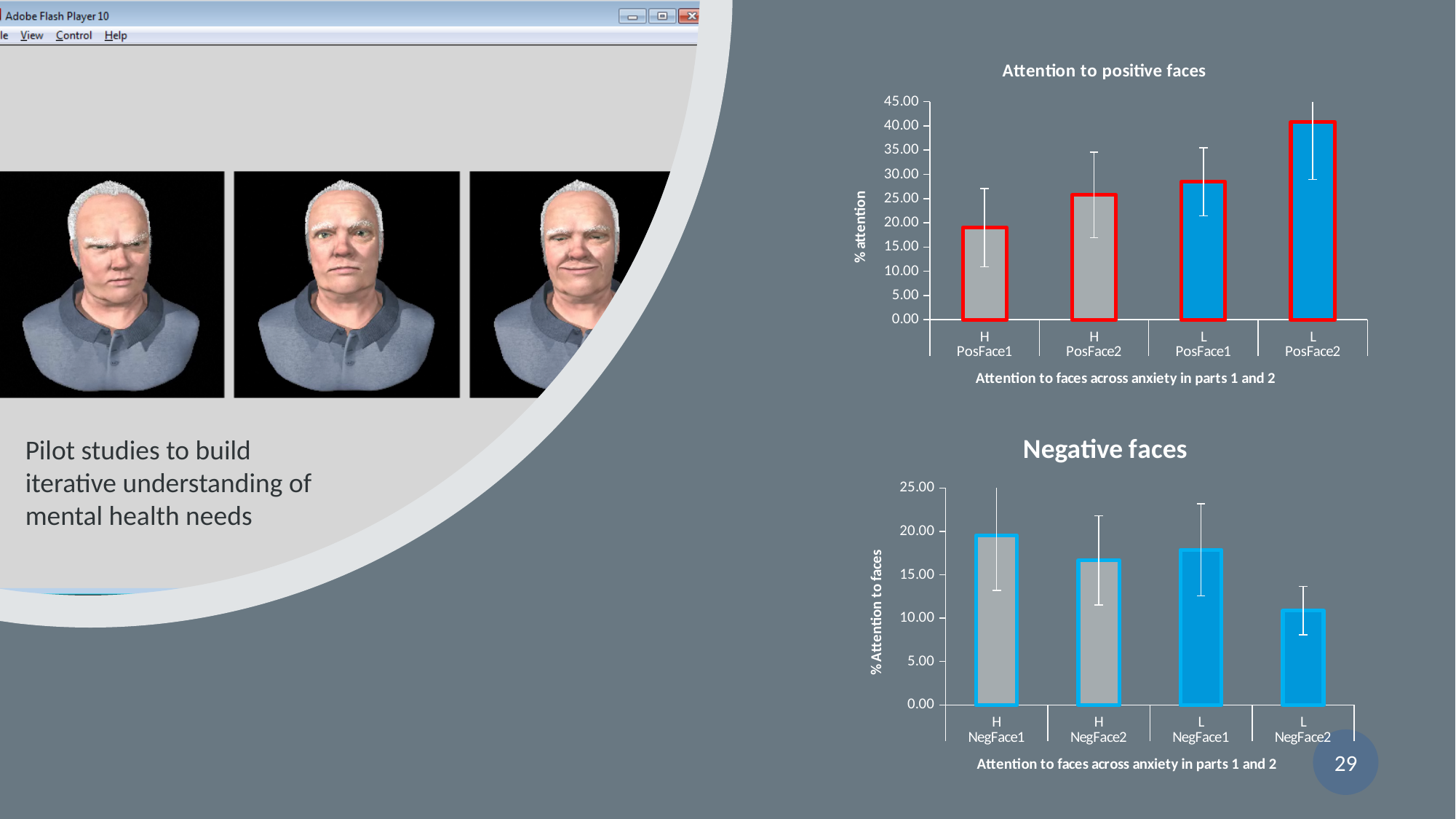
In the 'Negative faces' chart, is the value for L NegFace2 greater or less than 15.00? less In the 'Negative faces' chart, what is the label on the horizontal axis? Attention to faces across anxiety in parts 1 and 2 In the 'Attention to positive faces' chart, is the value for H PosFace1 greater or less than 20.00? less In the 'Attention to positive faces' chart, what is the label on the vertical axis? % attention In the 'Negative faces' chart, which is larger, the value for H NegFace1 or the value for L NegFace2? H NegFace1 In the 'Attention to positive faces' chart, which category has the highest value? L PosFace2 In the 'Attention to positive faces' chart, which category has the lowest value? H PosFace1 In the 'Attention to positive faces' chart, how many bars are plotted? 4 In the 'Negative faces' chart, which category has the lowest value? L NegFace2 In the 'Attention to positive faces' chart, do the values rise or fall from left to right across the categories? rise In the 'Attention to positive faces' chart, what kind of chart is shown? bar chart In the 'Attention to positive faces' chart, is the value for L PosFace2 greater or less than 35.00? greater